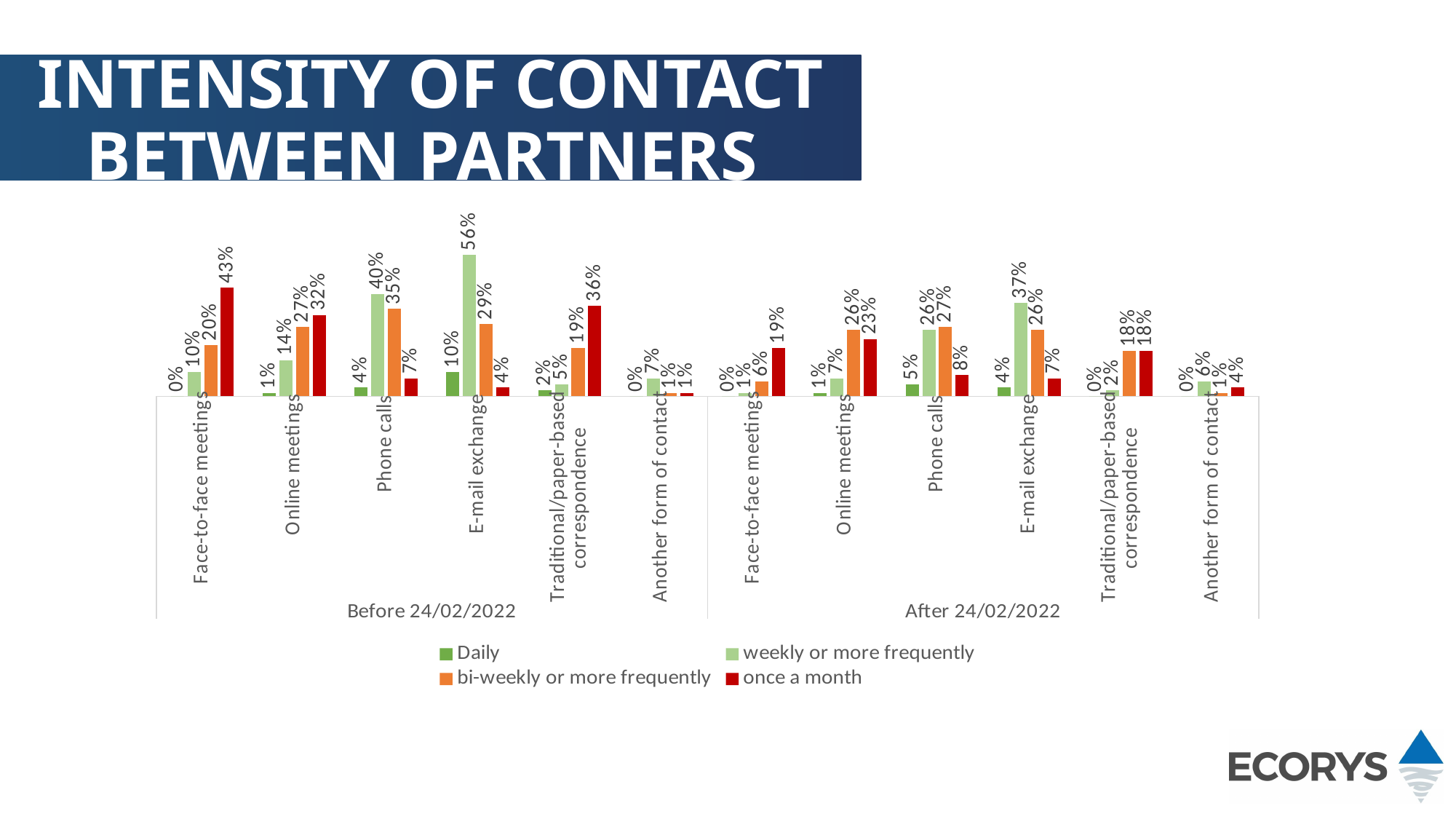
What is the value for 'weekly or more frequently' for E-mail exchange before 24/02/2022? 56% How many series does the legend list? 4 Which form of contact has the highest 'weekly or more frequently' value after 24/02/2022? E-mail exchange Which form of contact has the highest 'once a month' value before 24/02/2022? Face-to-face meetings Which is larger: the 'once a month' value for Online meetings before 24/02/2022 or after 24/02/2022? Before 24/02/2022 What is the difference between the 'weekly or more frequently' values for E-mail exchange before and after 24/02/2022? 19% What is the 'bi-weekly or more frequently' value for Phone calls before 24/02/2022? 35% What kind of chart is shown on the slide? Bar chart Which colour represents the 'once a month' series? Red How many forms of contact are shown in each period? 6 What is the value for 'once a month' for Face-to-face meetings after 24/02/2022? 19% What is the 'Daily' value for Phone calls after 24/02/2022? 5%